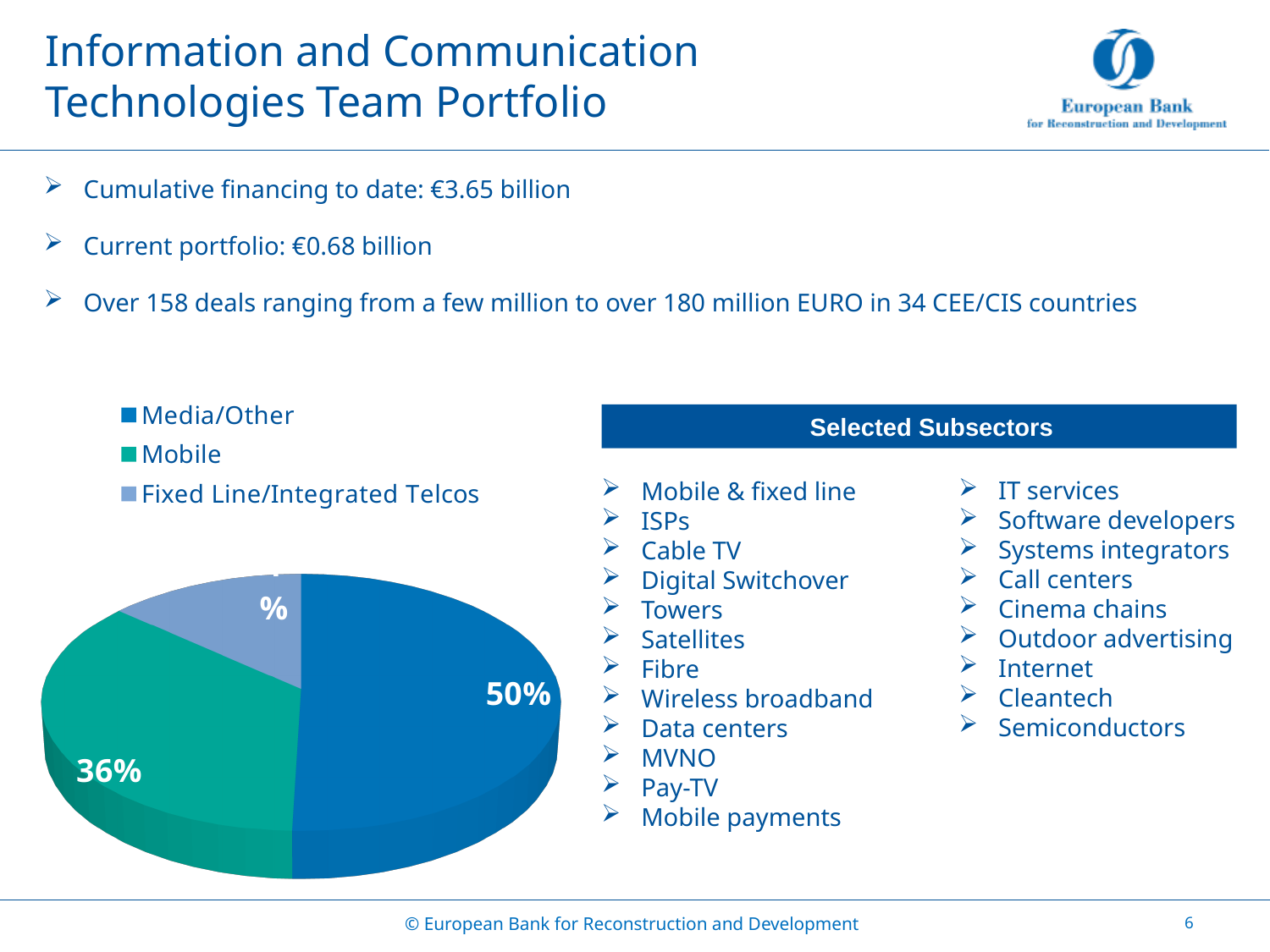
Which slice is larger in the pie chart, Mobile or Fixed Line/Integrated Telcos? Mobile Which category is listed first in the pie chart's legend? Media/Other What colour is the Mobile slice in the pie chart? Green What percentage of the pie chart is Mobile? 36% How many slices does the pie chart have? 3 Which category has the smallest slice in the pie chart? Fixed Line/Integrated Telcos What share of the pie does the Media/Other slice represent? 50% What percentage of the pie chart is Media/Other? 50% Which slice is larger in the pie chart, Media/Other or Mobile? Media/Other Which category has the largest slice in the pie chart? Media/Other By how many percentage points does the Media/Other slice exceed the Mobile slice? 14 percentage points What kind of chart is shown on the slide? Pie chart